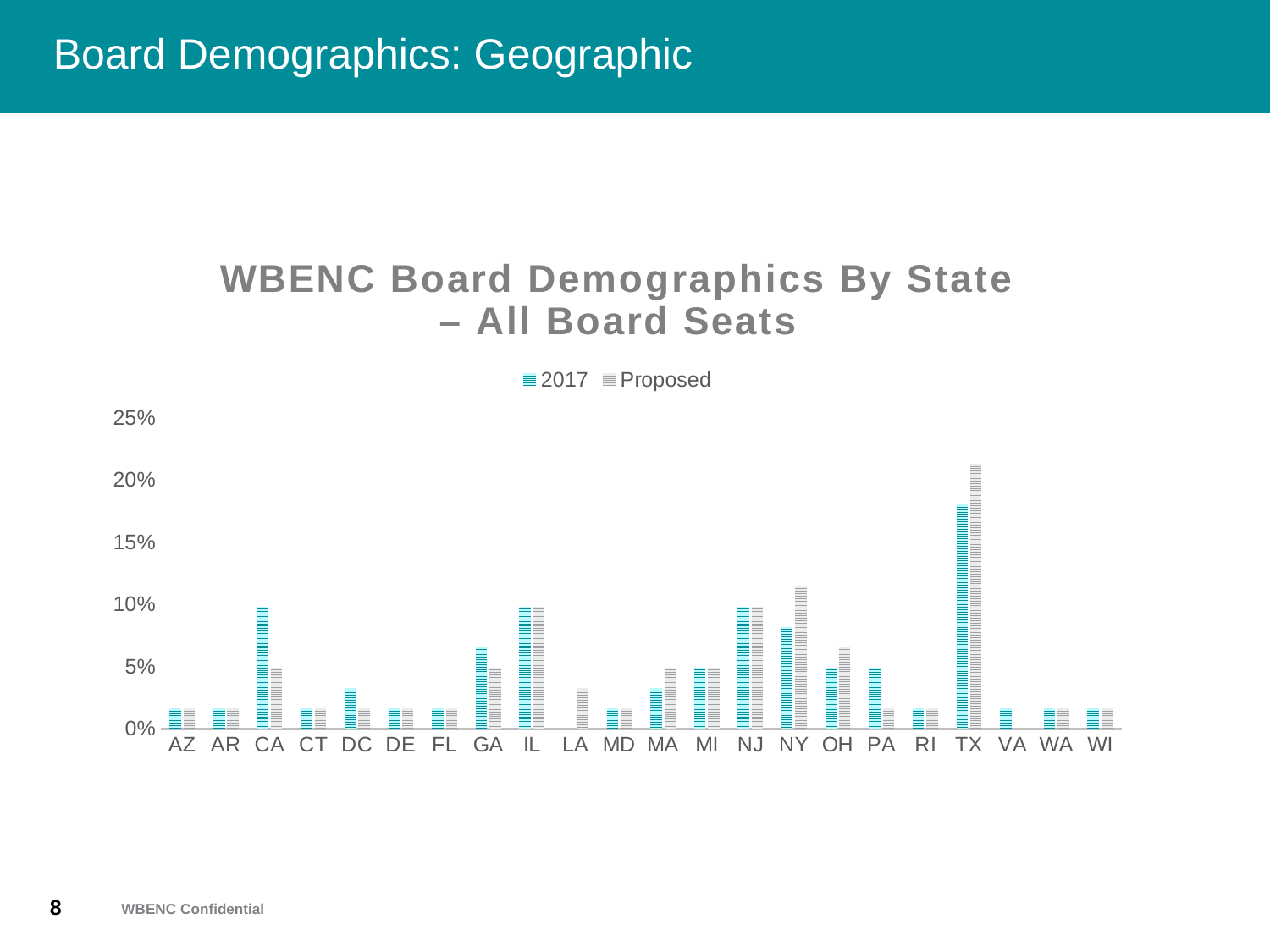
Is the 2017 value for GA greater or less than 5%? greater Is the Proposed value for TX greater or less than 20%? greater What is the title of the chart? WBENC Board Demographics By State – All Board Seats Which state has the highest Proposed value? TX How many states are shown on the x axis? 22 What kind of chart is shown on the slide? bar chart Is the 2017 value for TX greater or less than 15%? greater For CA, which is larger: the 2017 value or the Proposed value? 2017 For TX, which is larger: the 2017 value or the Proposed value? Proposed Which state has the highest 2017 value? TX How many series does the legend list? 2